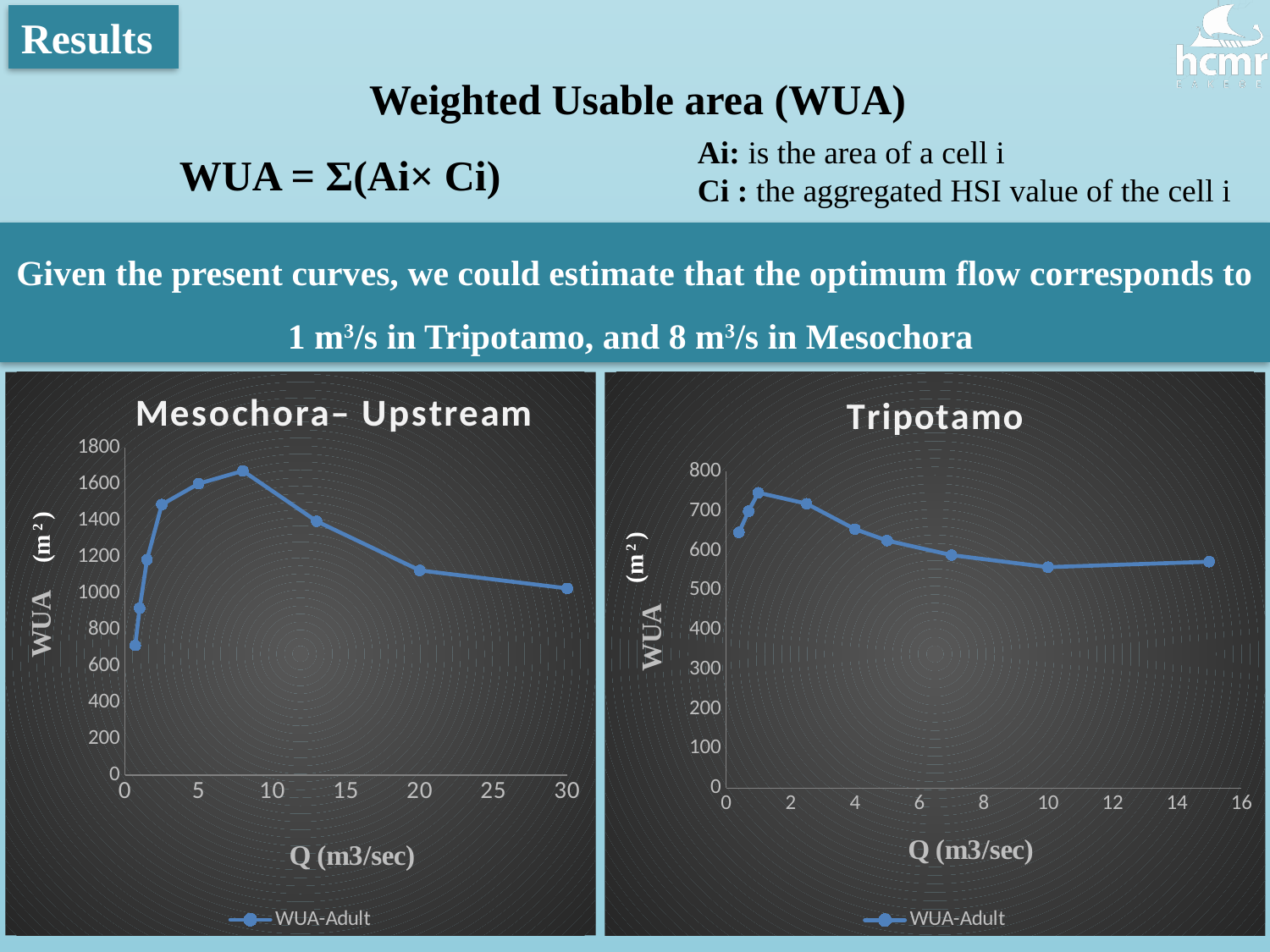
What is the x-axis title of the Tripotamo chart? Q (m3/sec) On the Tripotamo chart, is the value at Q = 10 greater or less than 600? less What is the legend entry shown on the Mesochora– Upstream chart? WUA-Adult On the Mesochora– Upstream chart, do the values rise or fall as Q increases from 10 to 30? fall On the Mesochora– Upstream chart, is the highest point of the curve greater or less than 1600? greater On the Tripotamo chart, which is larger: the value at Q = 4 or the value at Q = 10? Q = 4 On the Tripotamo chart, is the highest point of the curve greater or less than 700? greater What kind of chart is the Mesochora– Upstream chart? line chart How many data points are plotted on the Tripotamo chart? 9 How many series does the legend of the Tripotamo chart list? 1 How many data points are plotted on the Mesochora– Upstream chart? 9